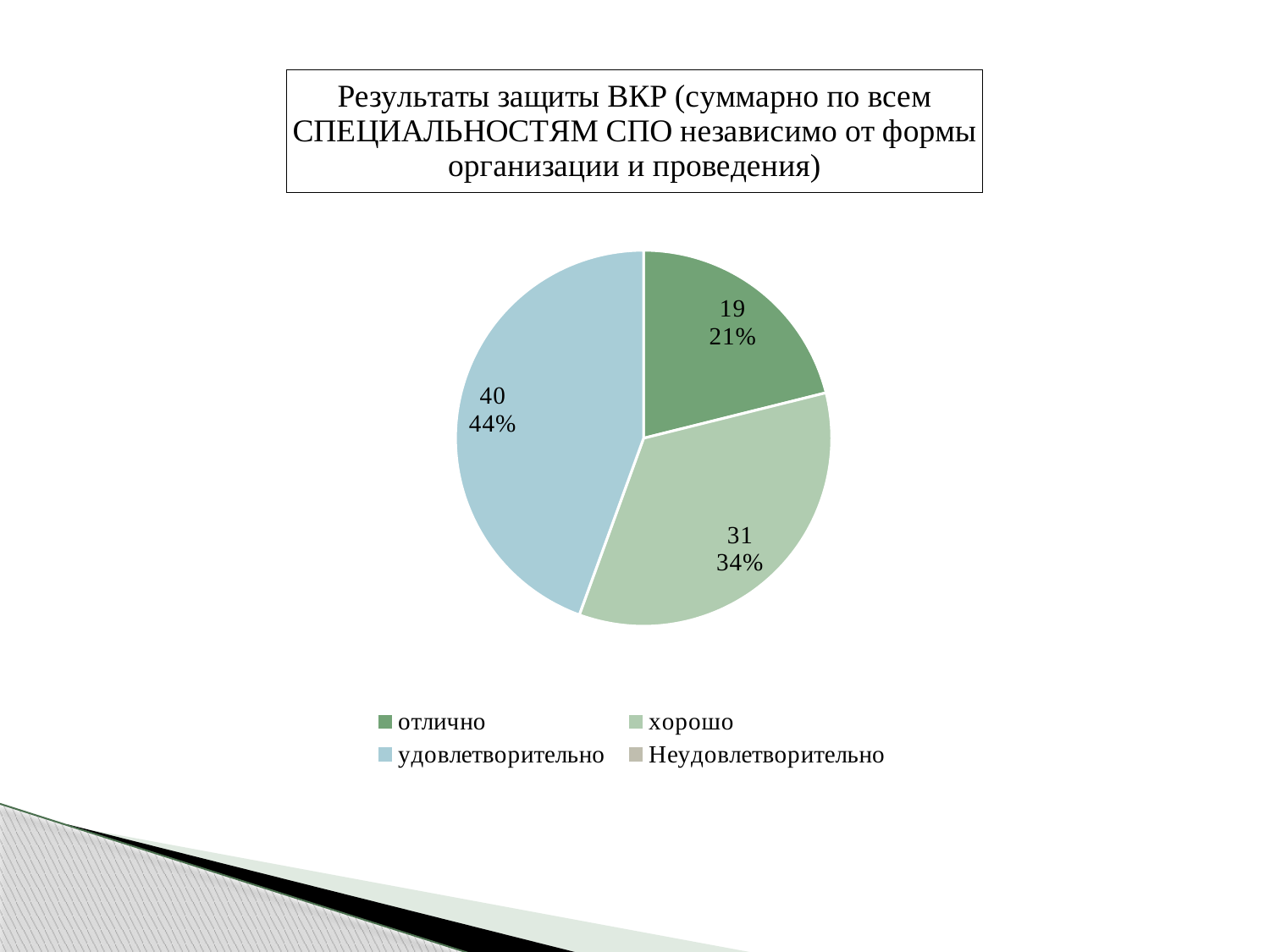
What kind of chart is shown on the slide? pie chart What is the value for удовлетворительно? 40 What is the value for отлично? 19 How many entries does the legend list? 4 What share of the pie does the отлично slice represent? 21% What share of the pie does the удовлетворительно slice represent? 44% Which is larger, the value for хорошо or the value for отлично? хорошо Which category has the largest slice? удовлетворительно What is the value for хорошо? 31 Which category has the smallest visible slice? отлично What is the difference between the values for удовлетворительно and отлично? 21 Which legend entry has no visible slice in the pie? Неудовлетворительно